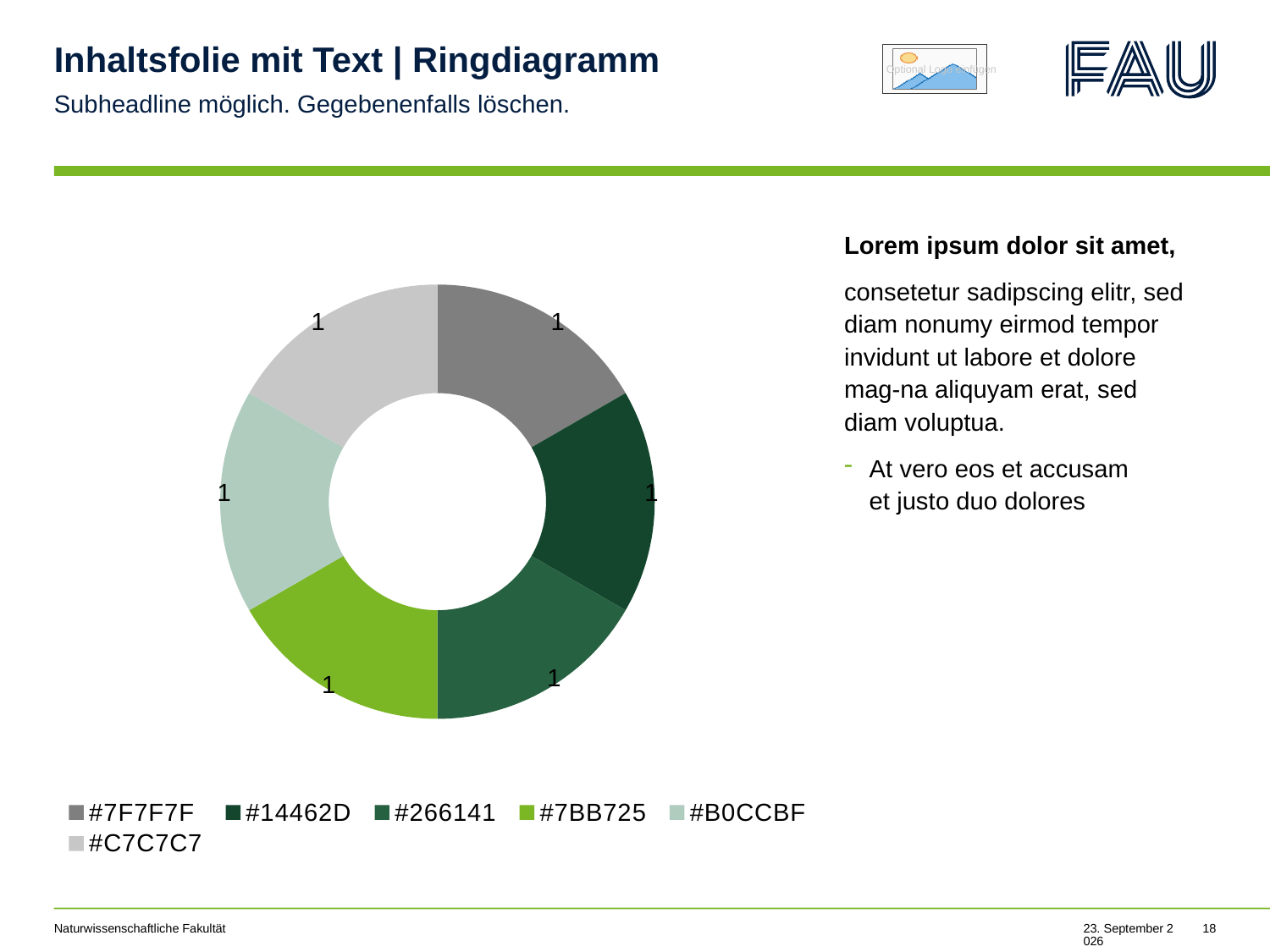
What is the value of the #14462D slice? 1 What is the difference between the values of the #266141 and #B0CCBF slices? 0 How many entries does the legend list? 6 How many slices does the doughnut chart have? 6 What is the value of the #7F7F7F slice? 1 What kind of chart is shown on the slide? doughnut chart What is the value of the #7BB725 slice? 1 Which legend entry is listed first? #7F7F7F What is the total of all slice values in the doughnut chart? 6 Which legend entry is listed last? #C7C7C7 What is the value of the #C7C7C7 slice? 1